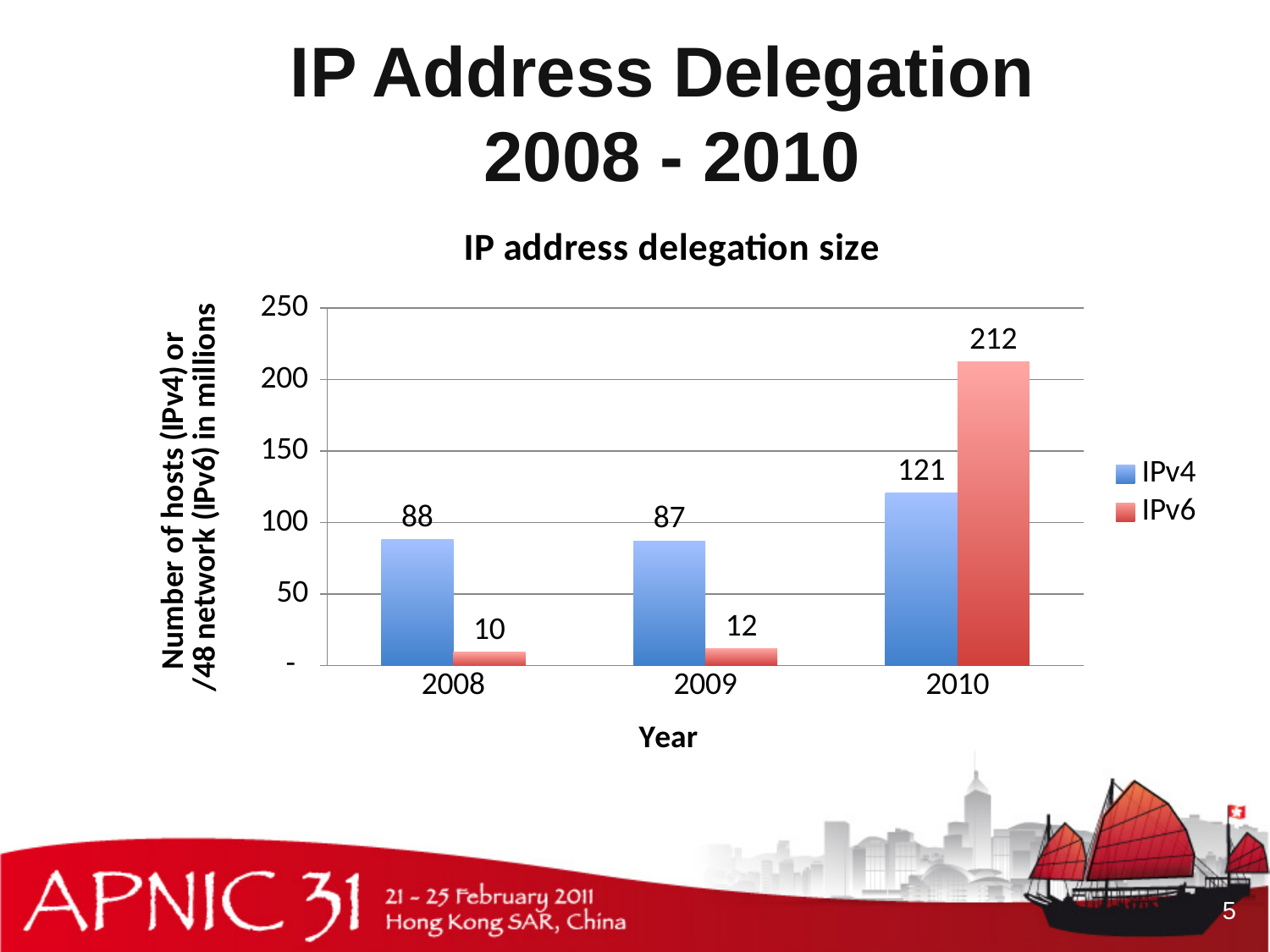
How many years are shown on the x axis? 3 How many series does the legend list? 2 Which is larger in 2010, the IPv4 value or the IPv6 value? IPv6 What is the IPv4 value for 2009? 87 Which year has the highest IPv6 value? 2010 What is the difference between the IPv6 value for 2010 and the IPv6 value for 2009? 200 Which year has the lowest IPv4 value? 2009 Is the IPv6 value for 2010 greater or less than 200? greater What is the IPv4 value for 2010? 121 What is the IPv6 value for 2008? 10 What kind of chart is shown on the slide? bar chart What is the title of the chart? IP address delegation size